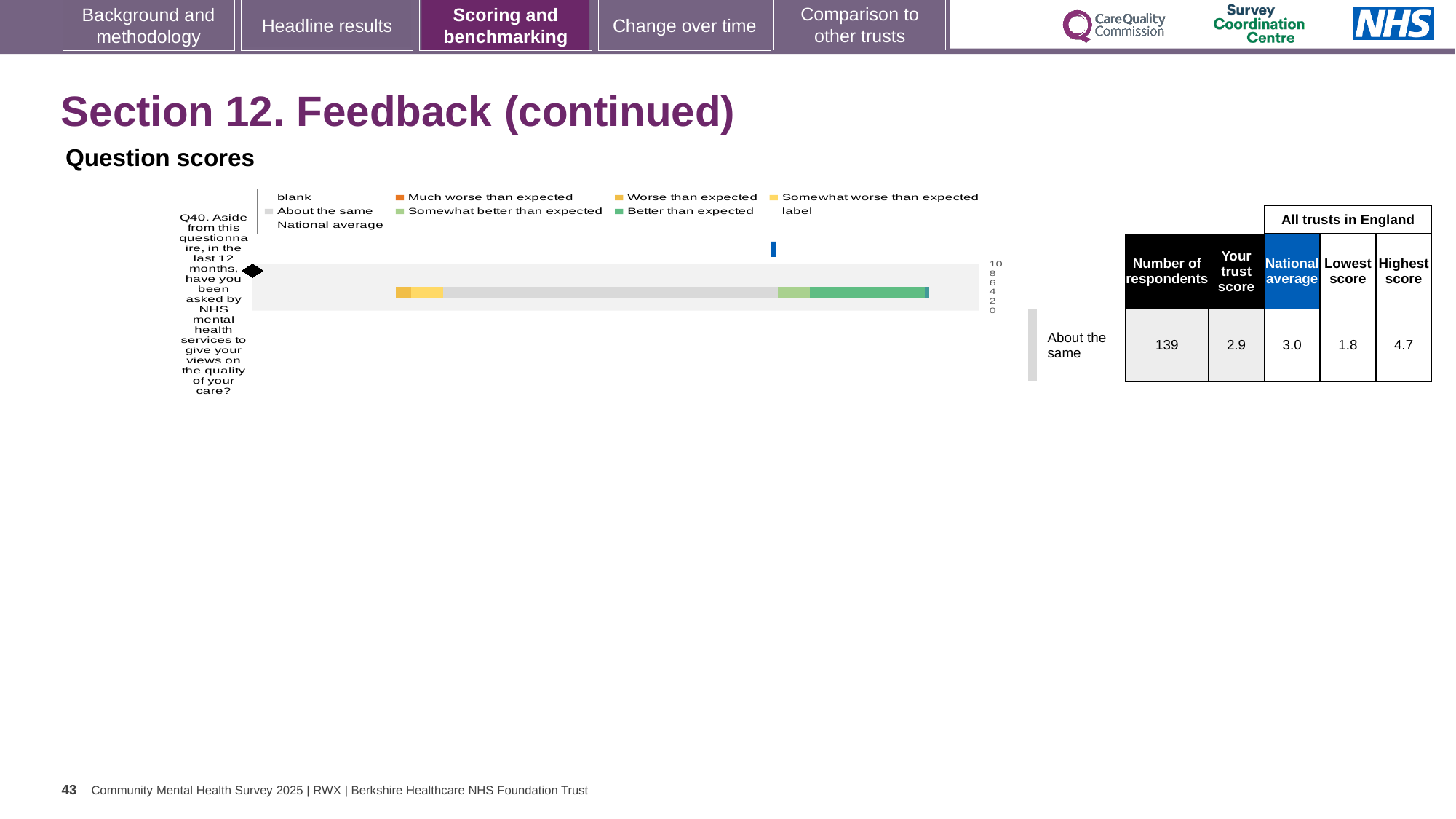
What is the difference between the national average and the trust's score for Q40? 0.1 What kind of chart is shown on the slide? bar chart How many questions (categories) are plotted in the chart? 1 According to the table beside the chart, what is the highest score among all trusts in England for Q40? 4.7 According to the table beside the chart, what is the national average for Q40? 3.0 Which is larger for Q40: the trust's score or the national average? National average According to the table beside the chart, what is the number of respondents for Q40? 139 What is the difference between the highest and lowest scores among all trusts in England for Q40? 2.9 What benchmarking category is the trust's result for Q40 labelled as? About the same According to the table beside the chart, what is the lowest score among all trusts in England for Q40? 1.8 According to the table beside the chart, what is the trust's score for Q40? 2.9 Which question number is plotted in the chart? Q40